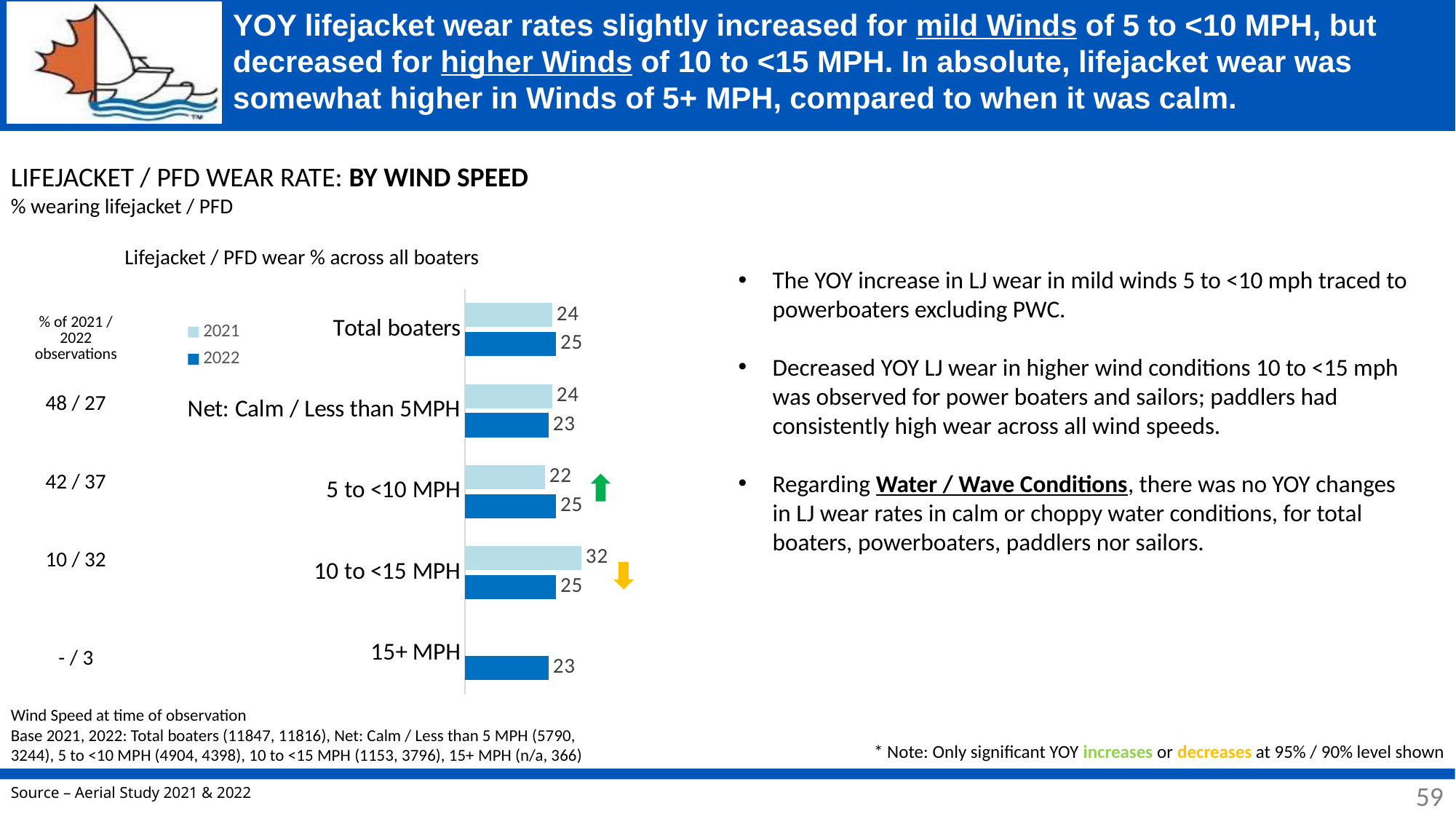
Which category has the highest 2021 value? 10 to <15 MPH What is the 2022 value for 15+ MPH? 23 Which category has no 2021 bar shown? 15+ MPH How many categories are shown on the chart? 5 What kind of chart is shown on the slide? Bar chart What is the 2022 value for Net: Calm / Less than 5MPH? 23 What is the 2021 lifejacket / PFD wear value for 10 to <15 MPH? 32 What is the 2022 lifejacket / PFD wear value for 5 to <10 MPH? 25 What is the difference between the 2021 and 2022 values for 10 to <15 MPH? 7 How many series does the legend list? 2 For 5 to <10 MPH, which year has the larger value, 2021 or 2022? 2022 Which category has the lowest 2021 value? 5 to <10 MPH